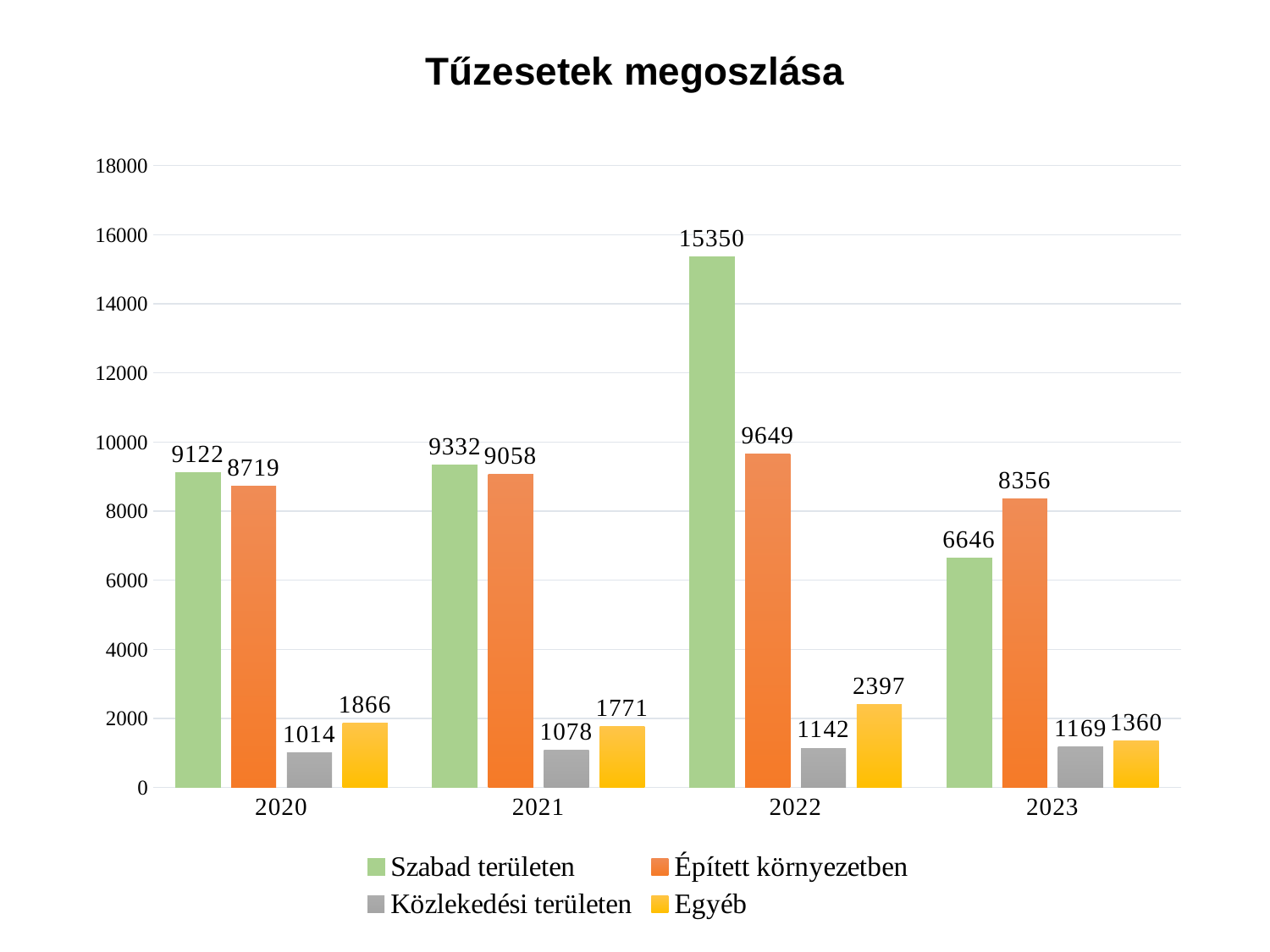
In which year is the Egyéb value lowest? 2023 What is the value for Közlekedési területen in 2020? 1014 How many series does the legend list? 4 What is the value for Szabad területen in 2022? 15350 How many years are shown on the x axis? 4 What is the value for Egyéb in 2021? 1771 Which is larger in 2023: Szabad területen or Épített környezetben? Épített környezetben What is the title of the chart? Tűzesetek megoszlása What is the difference between the Szabad területen and Épített környezetben values in 2022? 5701 In which year is the Szabad területen value highest? 2022 What kind of chart is this? Bar chart What is the value for Épített környezetben in 2023? 8356